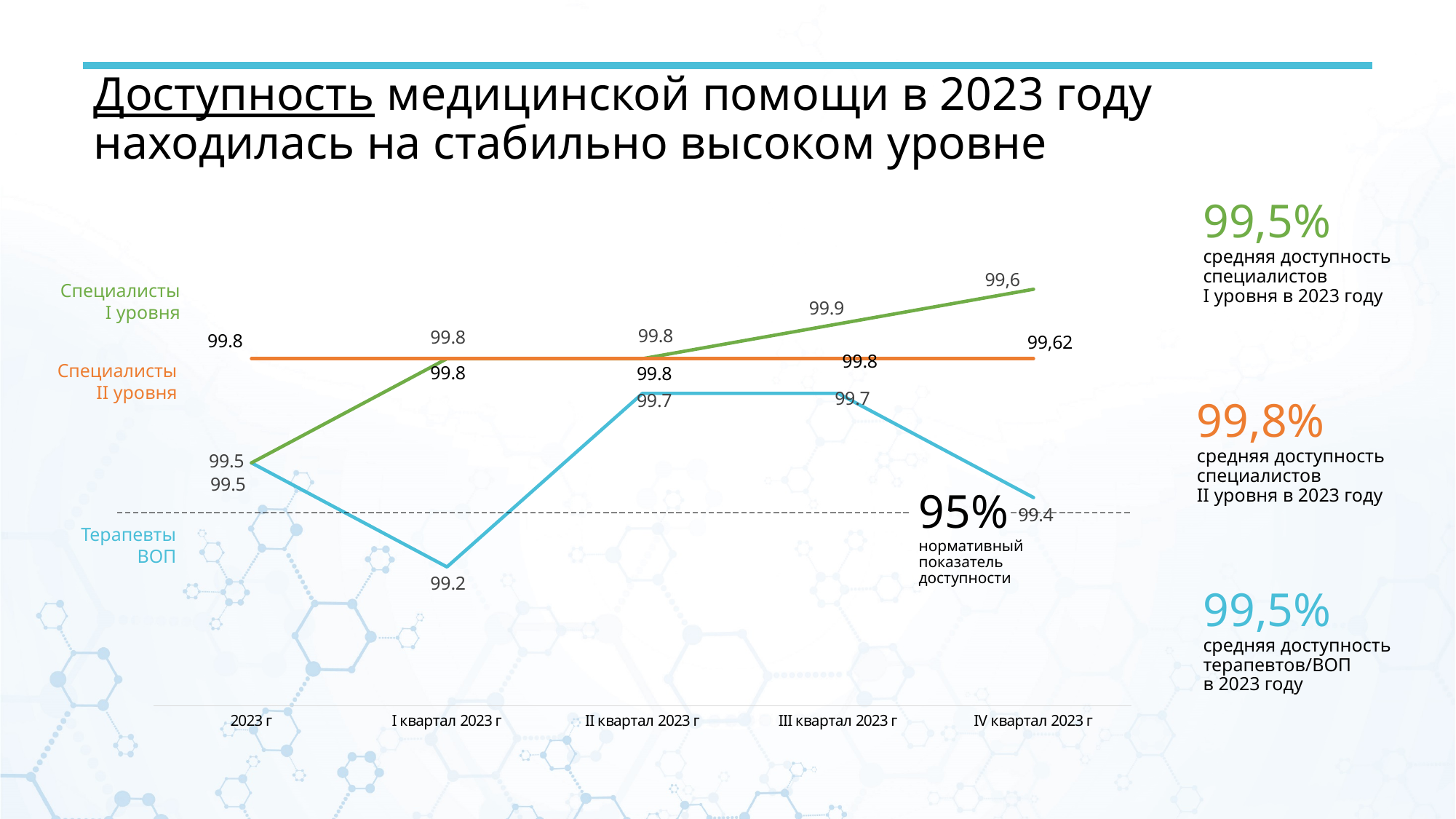
What is the value for Специалисты I уровня in III квартал 2023 г? 99.9 What is the value for Терапевты ВОП in I квартал 2023 г? 99.2 How many points are there along the x axis of the chart? 5 At which point on the x axis is the value for Терапевты ВОП lowest? I квартал 2023 г In IV квартал 2023 г, which is larger: the value for Специалисты I уровня or for Терапевты ВОП? Специалисты I уровня What is the difference between the Терапевты ВОП values in II квартал 2023 г and I квартал 2023 г? 0.5 What kind of chart is shown on the slide? line chart What normative accessibility indicator is marked by the dashed line on the chart? 95% How many series are plotted on the chart? 3 What is the value for Специалисты II уровня in IV квартал 2023 г? 99,62 Does the value for Терапевты ВОП rise or fall from III квартал 2023 г to IV квартал 2023 г? fall